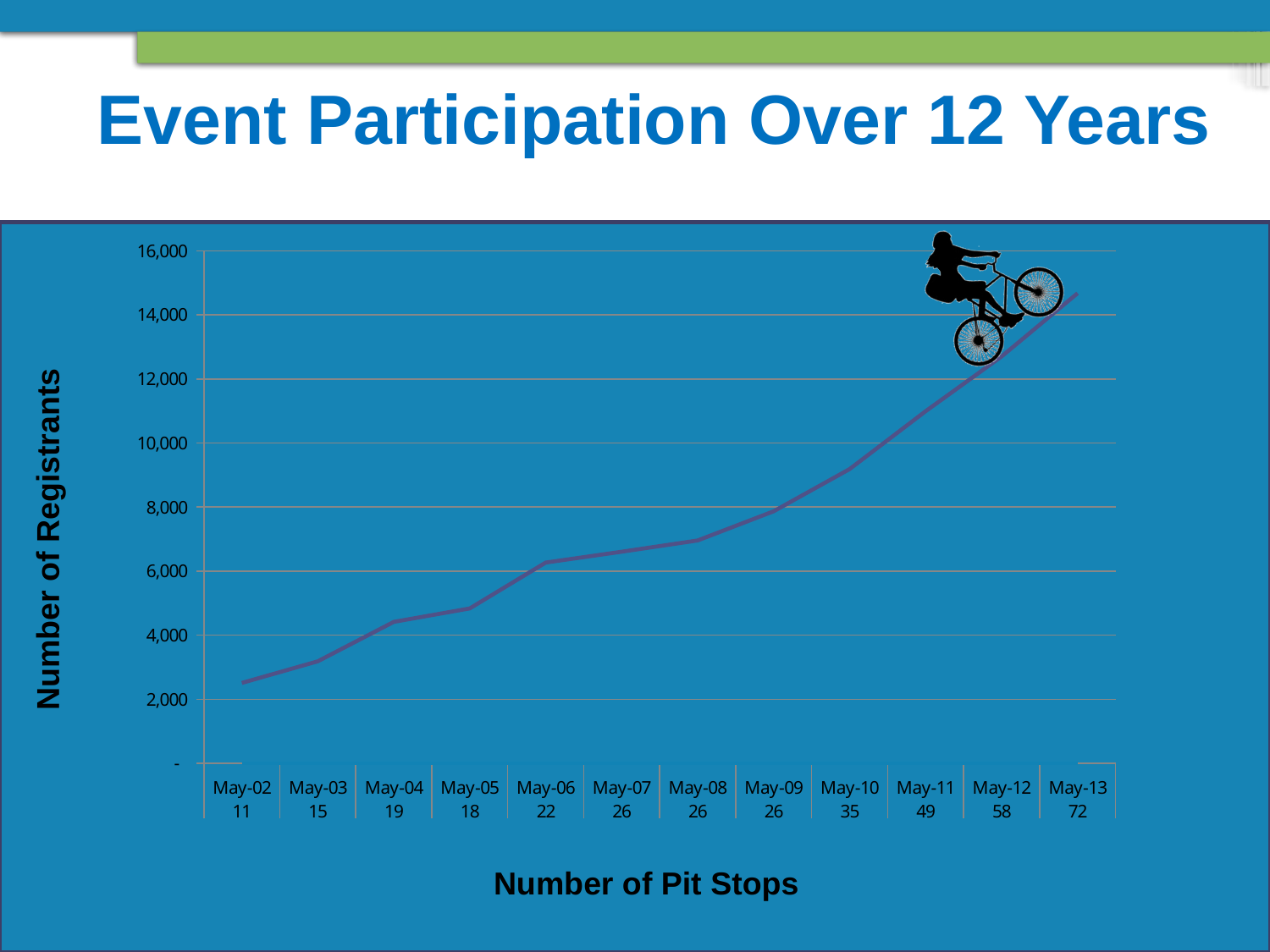
Is the number of registrants for May-11 greater or less than 10,000? greater How many pit stops are listed for May-13 on the x axis? 72 What kind of chart is shown on the slide? line chart What is the label of the y axis? Number of Registrants Is the number of registrants for May-13 greater or less than 14,000? greater How many pit stops are listed for May-02 on the x axis? 11 Is the number of registrants for May-10 greater or less than 10,000? less Which year has the highest number of registrants? May-13 Which year has the lowest number of registrants? May-02 How many data points (years) are plotted on the chart? 12 Do the number of registrants rise or fall from May-02 to May-13? rise